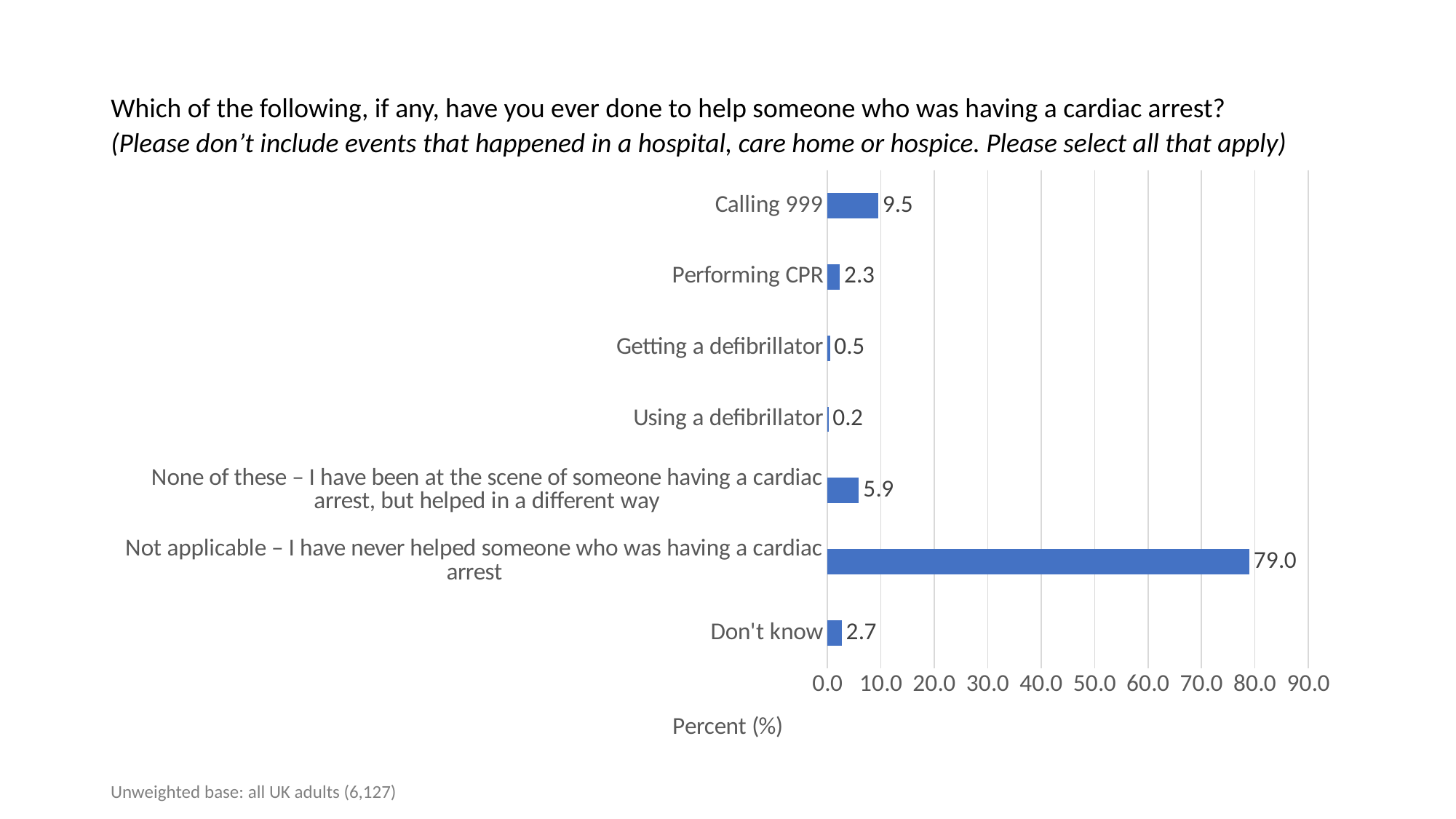
Which category has the lowest value? Using a defibrillator What is the label of the horizontal axis? Percent (%) What is the value for Don't know? 2.7 Which is larger, the value for Getting a defibrillator or the value for Don't know? Don't know Is the value for Not applicable – I have never helped someone who was having a cardiac arrest greater or less than 70.0? greater Which category has the highest value? Not applicable – I have never helped someone who was having a cardiac arrest What kind of chart is shown on the slide? bar chart What is the value for Calling 999? 9.5 What is the value for Using a defibrillator? 0.2 What is the value for Performing CPR? 2.3 How many categories are shown in the chart? 7 What is the difference between the values for Calling 999 and Performing CPR? 7.2